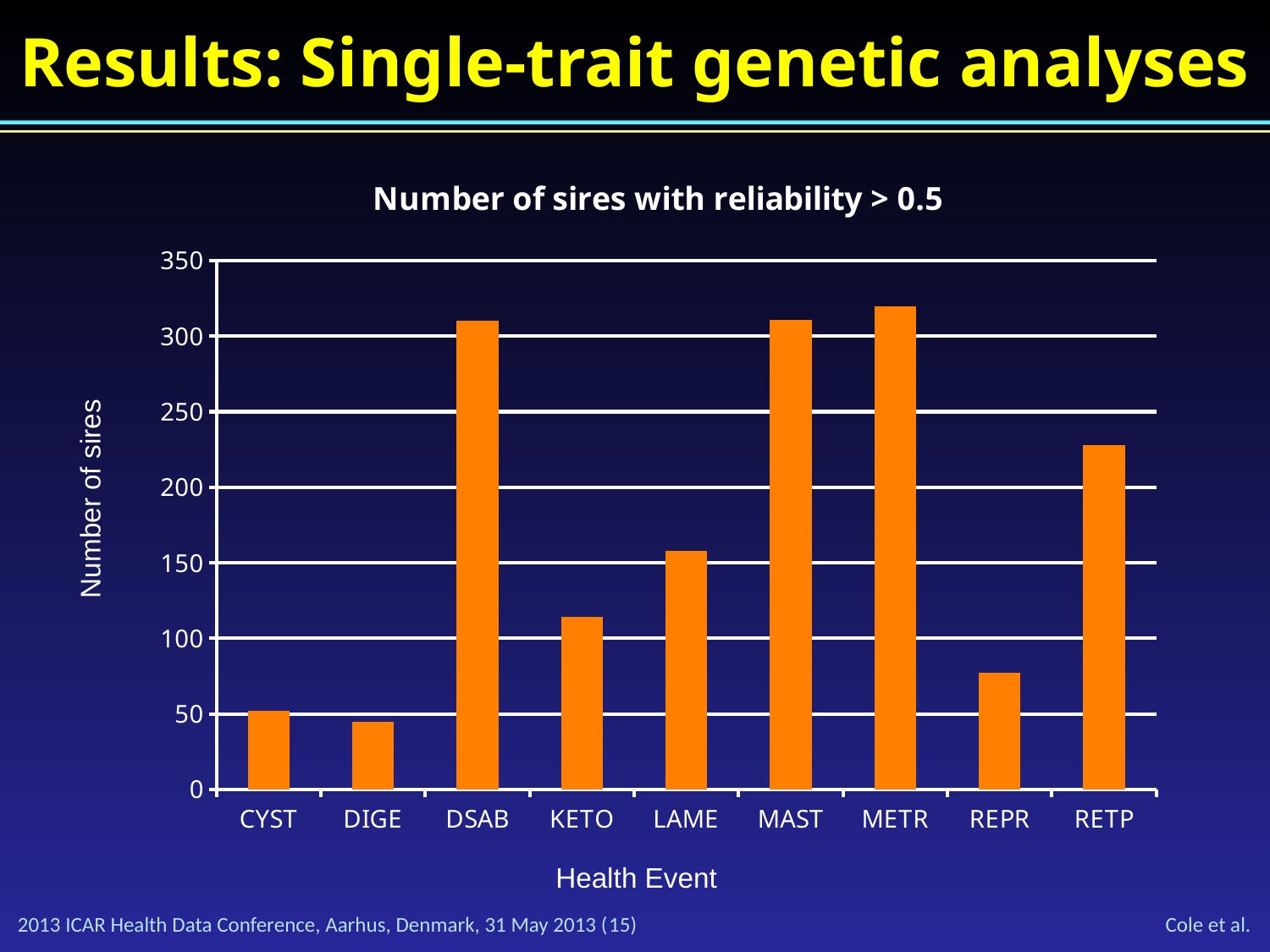
Is the value for RETP greater or less than 200? greater Which has more sires with reliability > 0.5, DSAB or KETO? DSAB Is the value for LAME greater or less than 200? less How many health event categories are plotted on the x axis? 9 Is the value for DSAB greater or less than 300? greater What is the title of the chart? Number of sires with reliability > 0.5 What is the label of the x axis? Health Event Which has more sires with reliability > 0.5, RETP or LAME? RETP What kind of chart is shown on the slide? bar chart